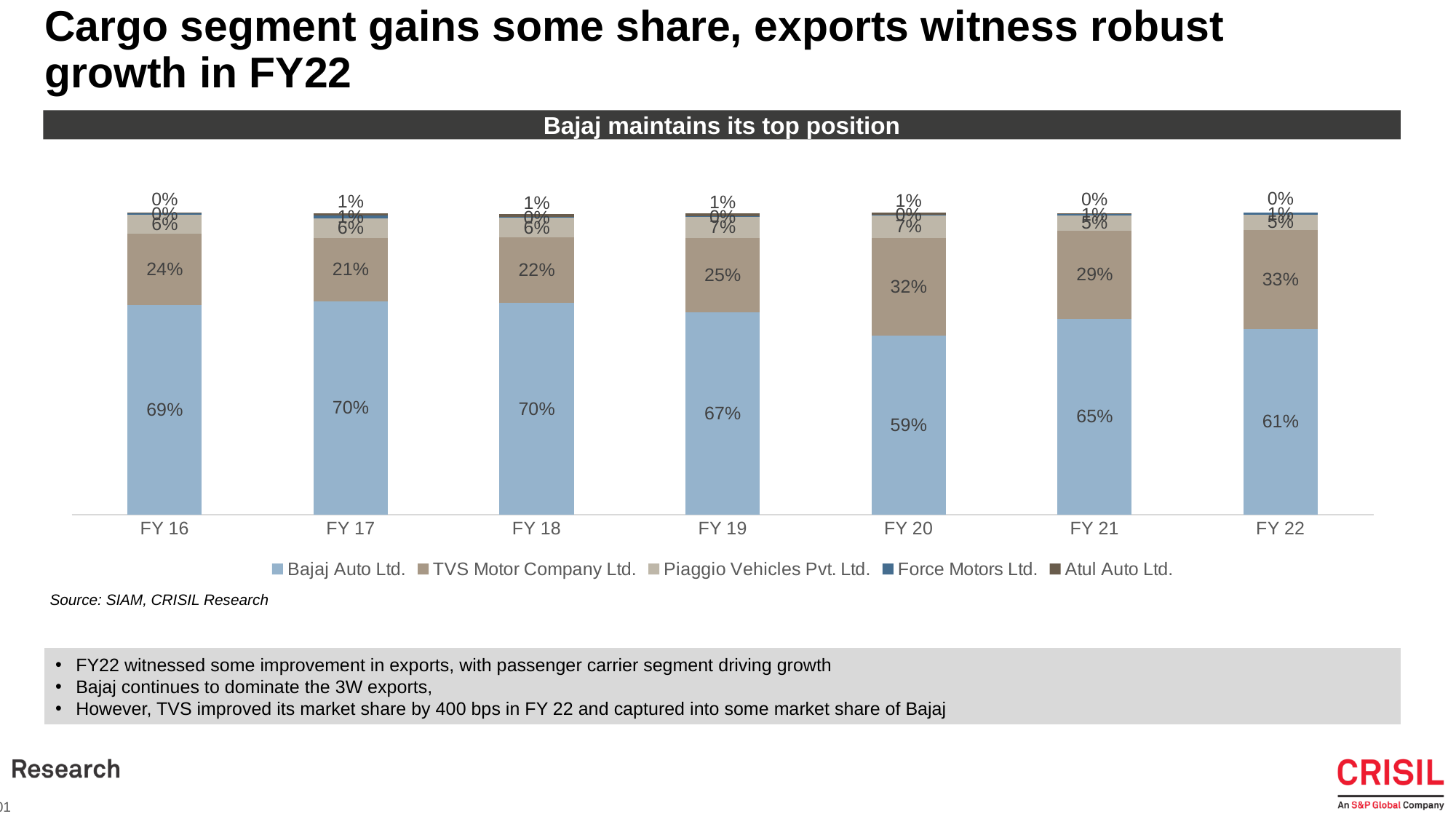
In which fiscal year is the Bajaj Auto Ltd. share lowest? FY 20 Which is larger: the TVS Motor Company Ltd. share in FY 21 or in FY 19? FY 21 What is the title shown in the dark banner above the chart? Bajaj maintains its top position What is the value for TVS Motor Company Ltd. in FY 20? 32% Does the TVS Motor Company Ltd. share rise or fall from FY 19 to FY 20? Rise In which fiscal year is the TVS Motor Company Ltd. share highest? FY 22 What kind of chart is shown on the slide? Stacked bar chart What is the difference between the Bajaj Auto Ltd. share in FY 16 and in FY 22? 8% What is the value for Piaggio Vehicles Pvt. Ltd. in FY 19? 7% How many fiscal years are shown on the x axis? 7 What is the value for Bajaj Auto Ltd. in FY 22? 61% How many series does the legend list? 5